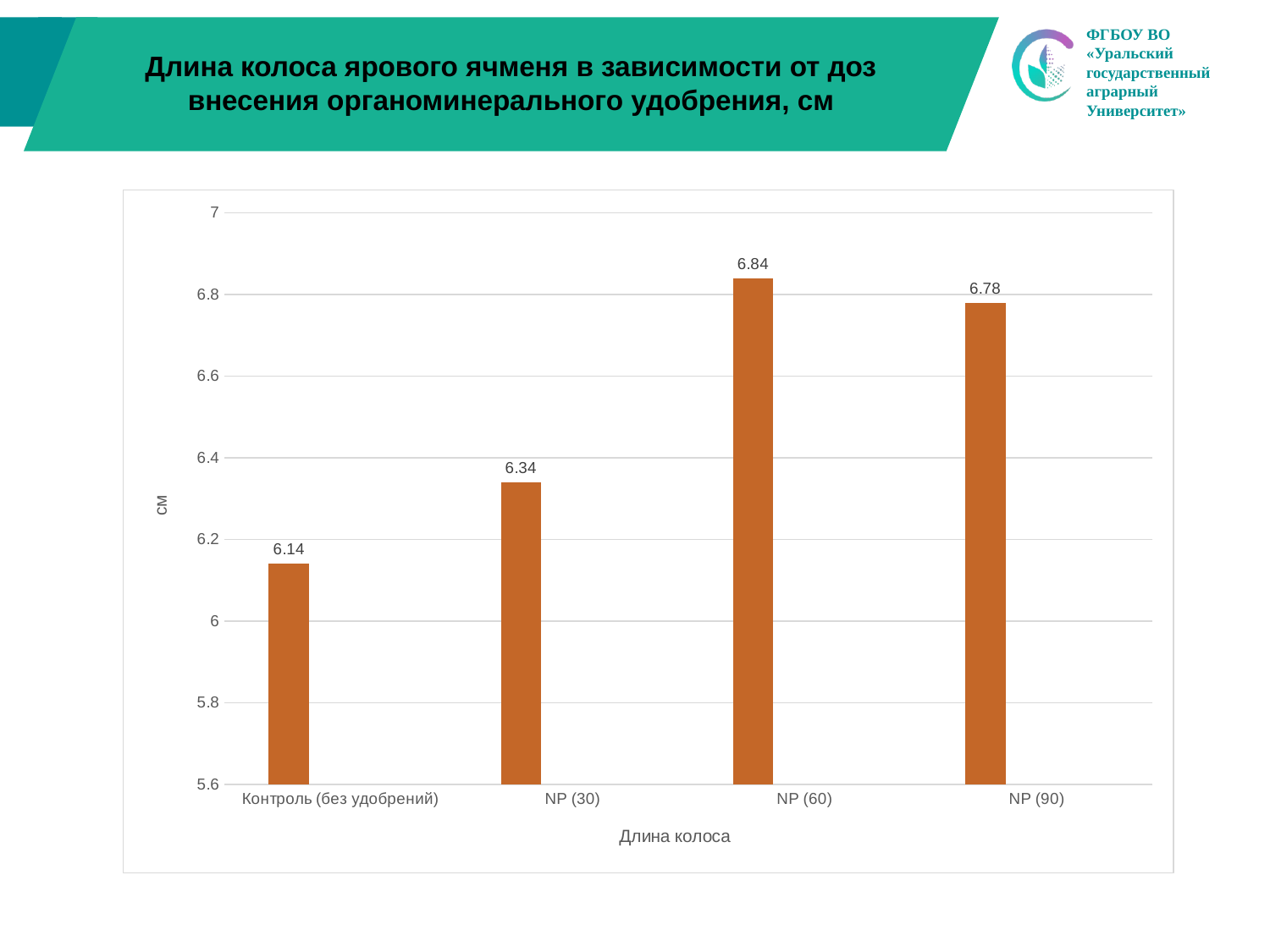
What is the value for Контроль (без удобрений)? 6.14 Which is larger, the value for NP (30) or the value for NP (90)? NP (90) What is the difference between the values for NP (60) and Контроль (без удобрений)? 0.7 What is the value for NP (90)? 6.78 What is the difference between the values for NP (90) and NP (30)? 0.44 Which category has the lowest value? Контроль (без удобрений) What is the value for NP (30)? 6.34 Which category has the highest value? NP (60) What kind of chart is this? Bar chart How many categories are shown on the x axis? 4 What is the label of the vertical axis? см What is the value for NP (60)? 6.84